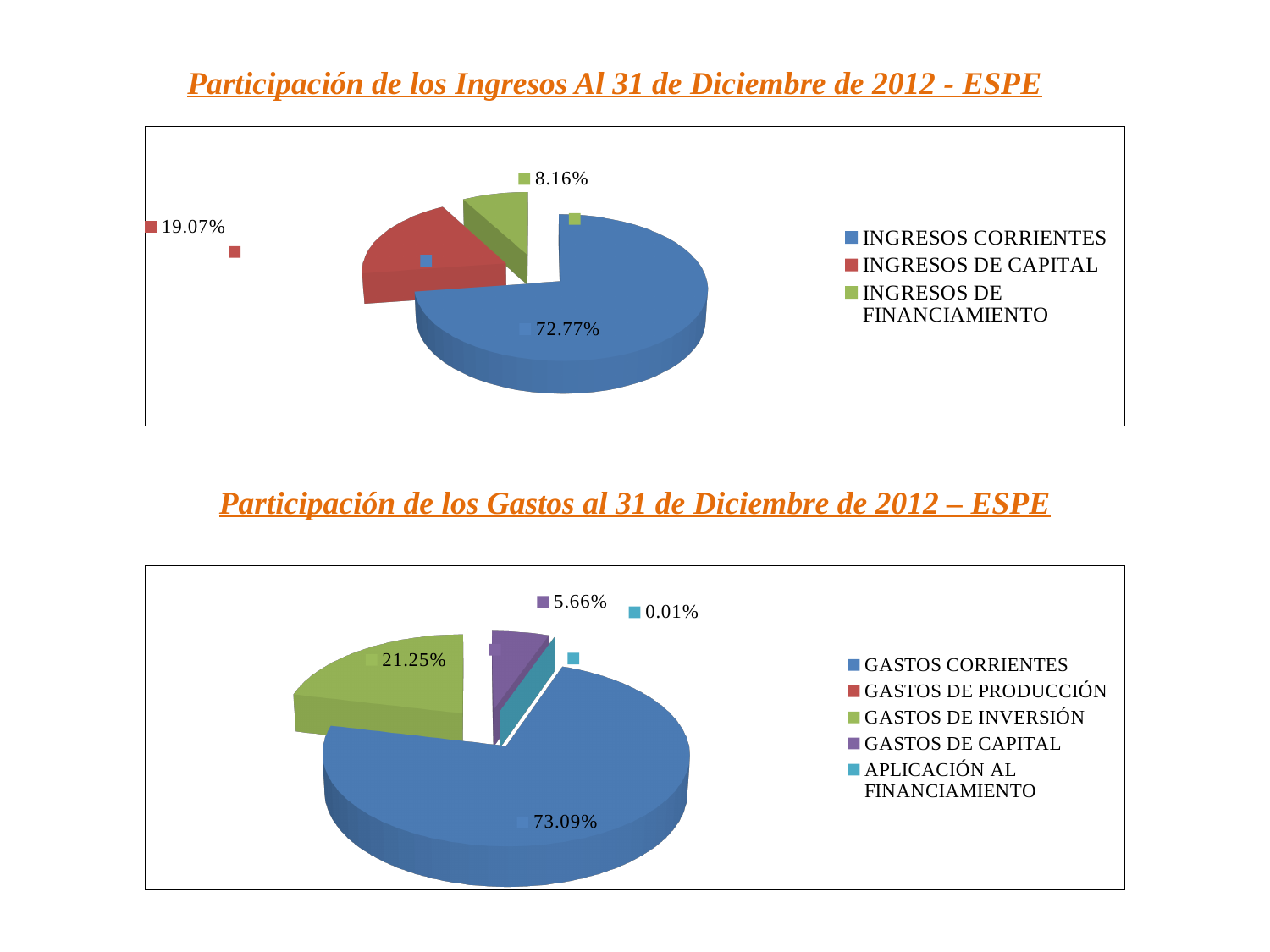
In the 'Participación de los Ingresos' chart, how many categories does the legend list? 3 In the 'Participación de los Ingresos' chart, which category has the smallest share? Ingresos de Financiamiento In the 'Participación de los Gastos' chart, how many categories does the legend list? 5 In the 'Participación de los Ingresos' chart, what is the value for Ingresos de Capital? 19.07% In the 'Participación de los Gastos' chart, what is the value for Gastos de Inversión? 21.25% In the 'Participación de los Gastos' chart, which is larger: Gastos de Inversión or Gastos de Capital? Gastos de Inversión In the 'Participación de los Gastos' chart, what is the value for Aplicación al Financiamiento? 0.01% In the 'Participación de los Gastos' chart, what share do Gastos Corrientes represent? 73.09% What type of chart is the 'Participación de los Ingresos' chart? Pie chart In the 'Participación de los Ingresos' chart, what share do Ingresos Corrientes represent? 72.77% In the 'Participación de los Ingresos' chart, what is the difference between Ingresos Corrientes and Ingresos de Capital? 53.70% In the 'Participación de los Ingresos' chart, what is the value for Ingresos de Financiamiento? 8.16%